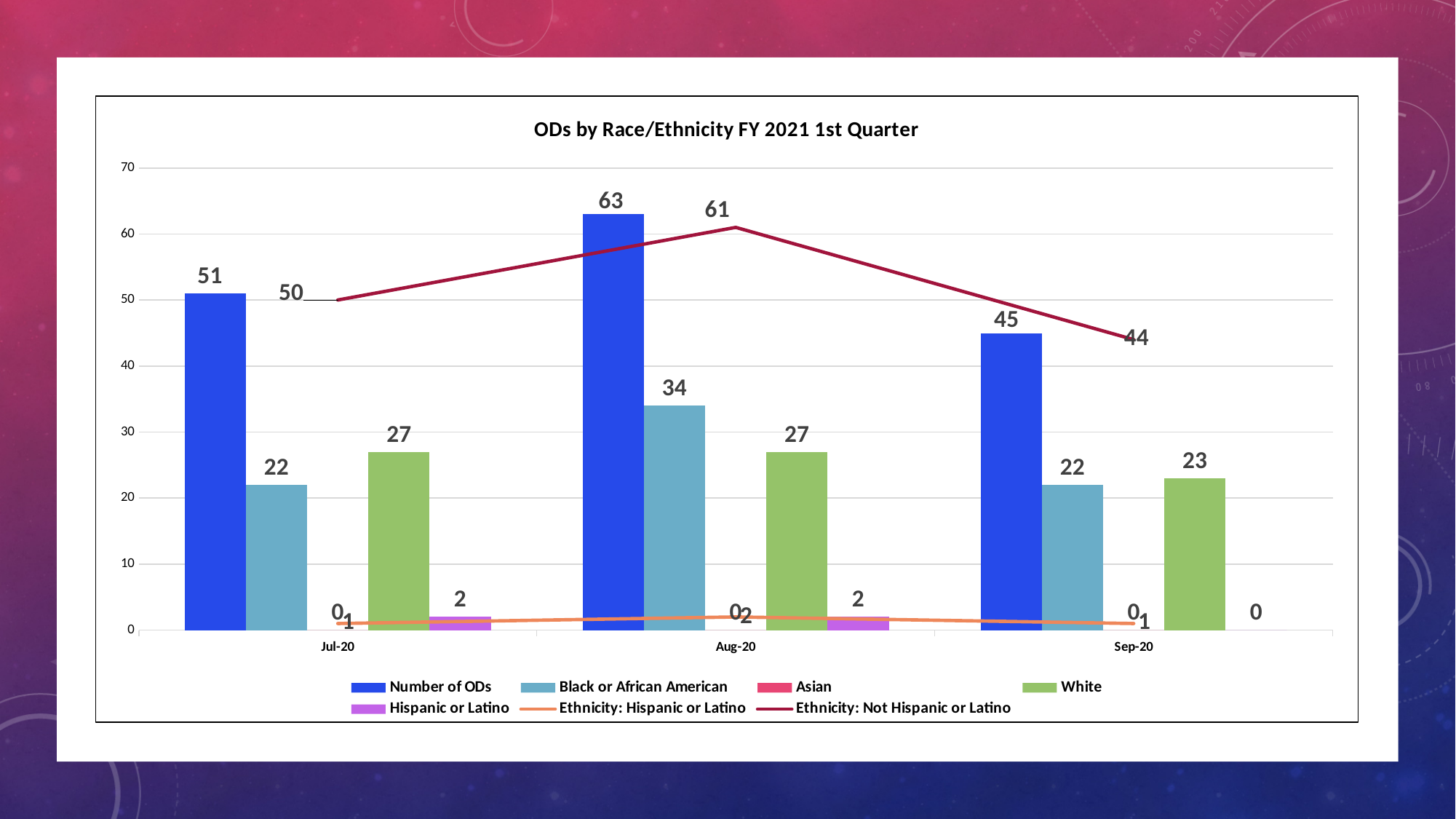
What is the value for Black or African American in Aug-20? 34 What is the Number of ODs for Aug-20? 63 What is the value for White in Sep-20? 23 Which month has the highest Number of ODs? Aug-20 Does the Ethnicity: Not Hispanic or Latino line rise or fall from Aug-20 to Sep-20? fall In Jul-20, which is larger: the value for White or for Black or African American? White How many series does the legend list? 7 What is the value of the Ethnicity: Not Hispanic or Latino line in Jul-20? 50 Which month has the lowest Number of ODs? Sep-20 What is the title of the chart? ODs by Race/Ethnicity FY 2021 1st Quarter What is the difference between the Number of ODs in Aug-20 and in Sep-20? 18 How many months are shown on the x axis? 3